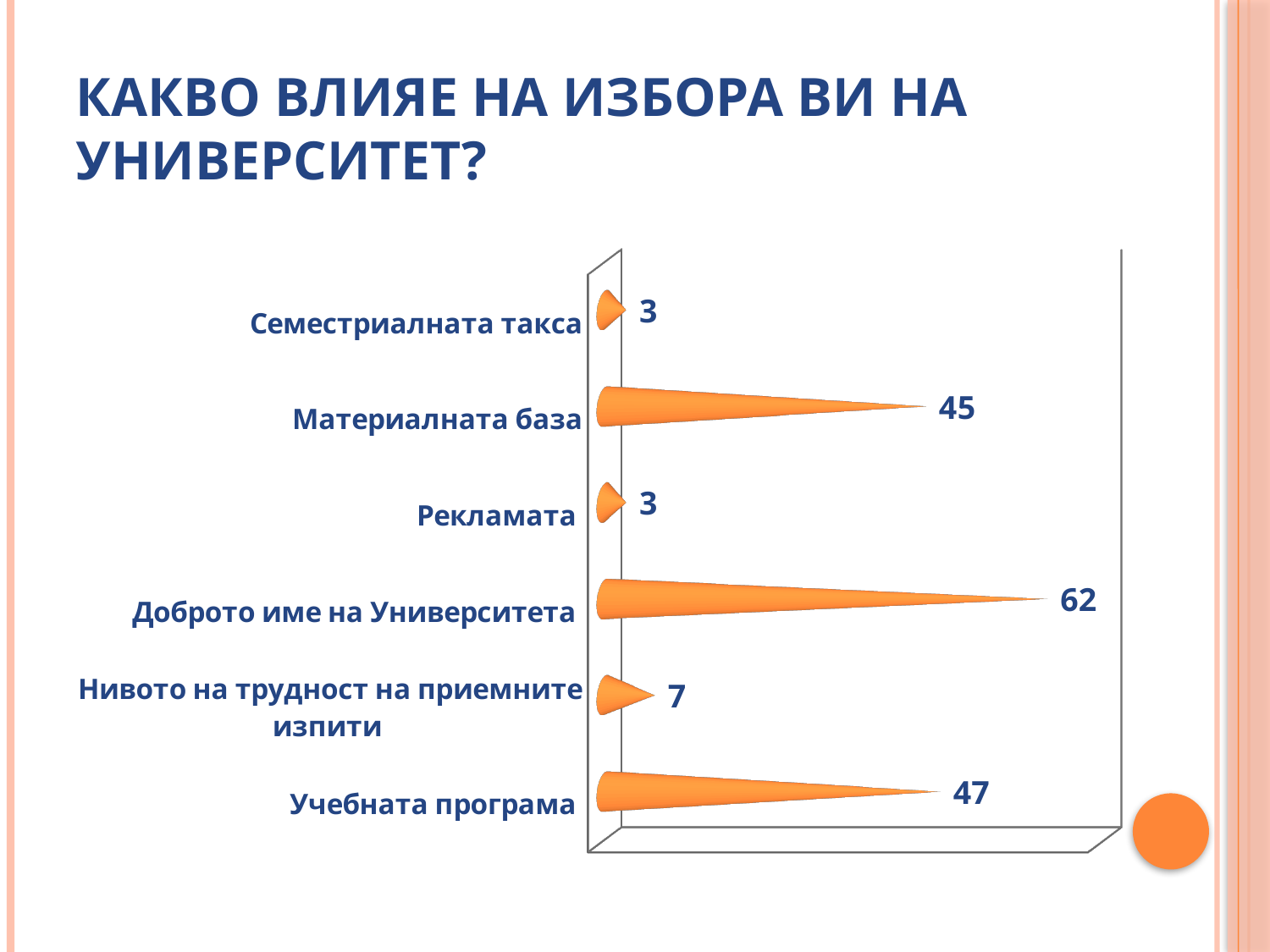
What kind of chart is shown on the slide? bar chart What is the difference between the values for Материалната база and Нивото на трудност на приемните изпити? 38 Which is larger, the value for Учебната програма or the value for Материалната база? Учебната програма What is the value for Доброто име на Университета? 62 What is the title of the slide containing the chart? КАКВО ВЛИЯЕ НА ИЗБОРА ВИ НА УНИВЕРСИТЕТ? What is the value for Учебната програма? 47 What is the value for Рекламата? 3 What is the value for Материалната база? 45 How many categories are shown in the chart? 6 Which category has the highest value? Доброто име на Университета What is the value for Нивото на трудност на приемните изпити? 7 What is the difference between the values for Доброто име на Университета and Учебната програма? 15